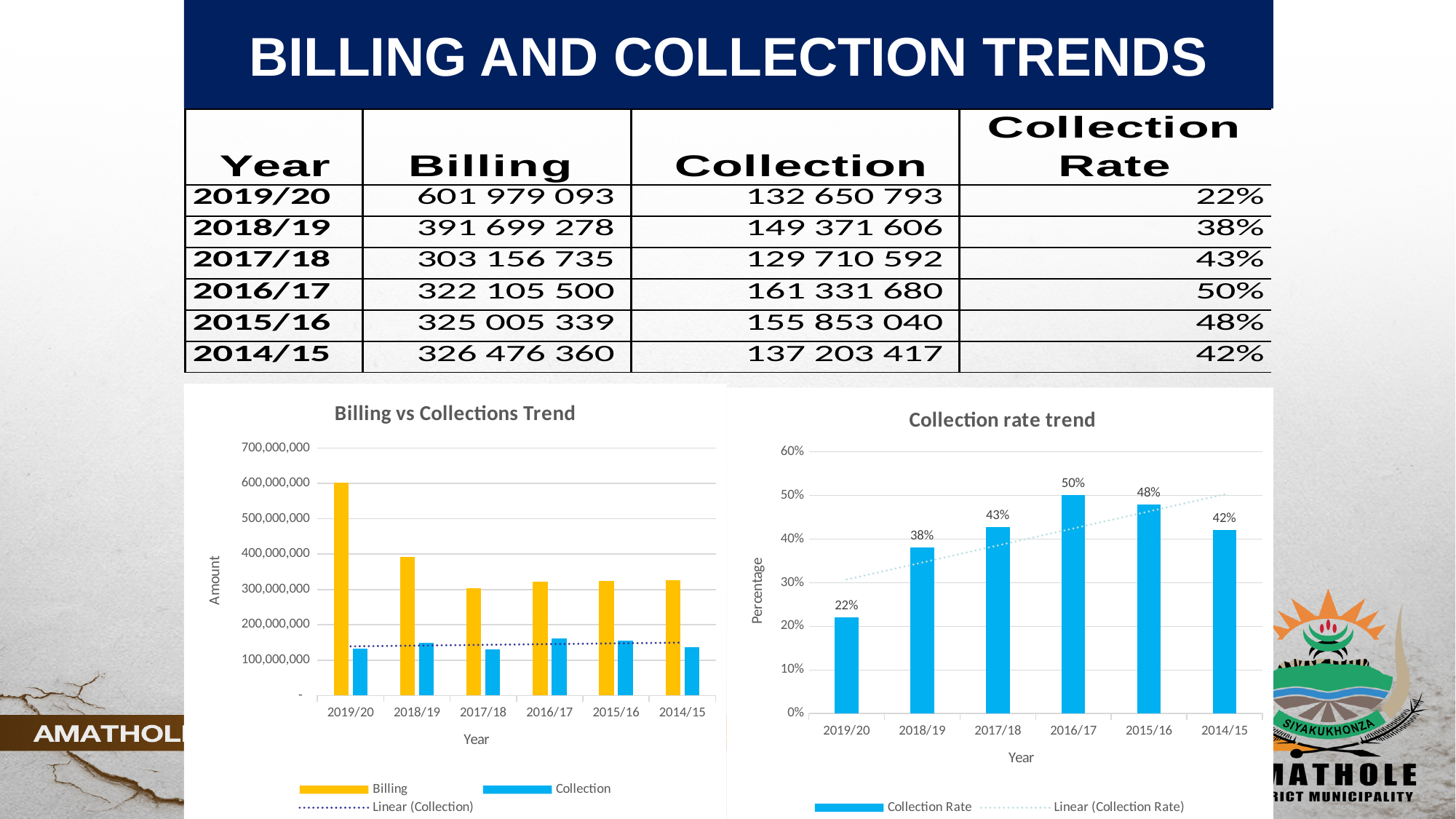
In the Collection rate trend chart, which year has the lowest collection rate? 2019/20 What kind of chart is the Billing vs Collections Trend chart? Bar chart In the Billing vs Collections Trend chart, is the Collection value for 2016/17 greater or less than 200,000,000? less In the Collection rate trend chart, what is the difference between the collection rates for 2018/19 and 2019/20? 16% In the Billing vs Collections Trend chart, which year has the highest Billing value? 2019/20 In the Collection rate trend chart, which year has the highest collection rate? 2016/17 How many years are shown on the x axis of the Collection rate trend chart? 6 In the Collection rate trend chart, what is the collection rate for 2016/17? 50% How many entries does the legend of the Billing vs Collections Trend chart list? 3 In the Collection rate trend chart, which year has a higher collection rate, 2017/18 or 2014/15? 2017/18 In the Billing vs Collections Trend chart, is the Billing value for 2019/20 greater or less than 500,000,000? greater In the Collection rate trend chart, what is the collection rate for 2019/20? 22%